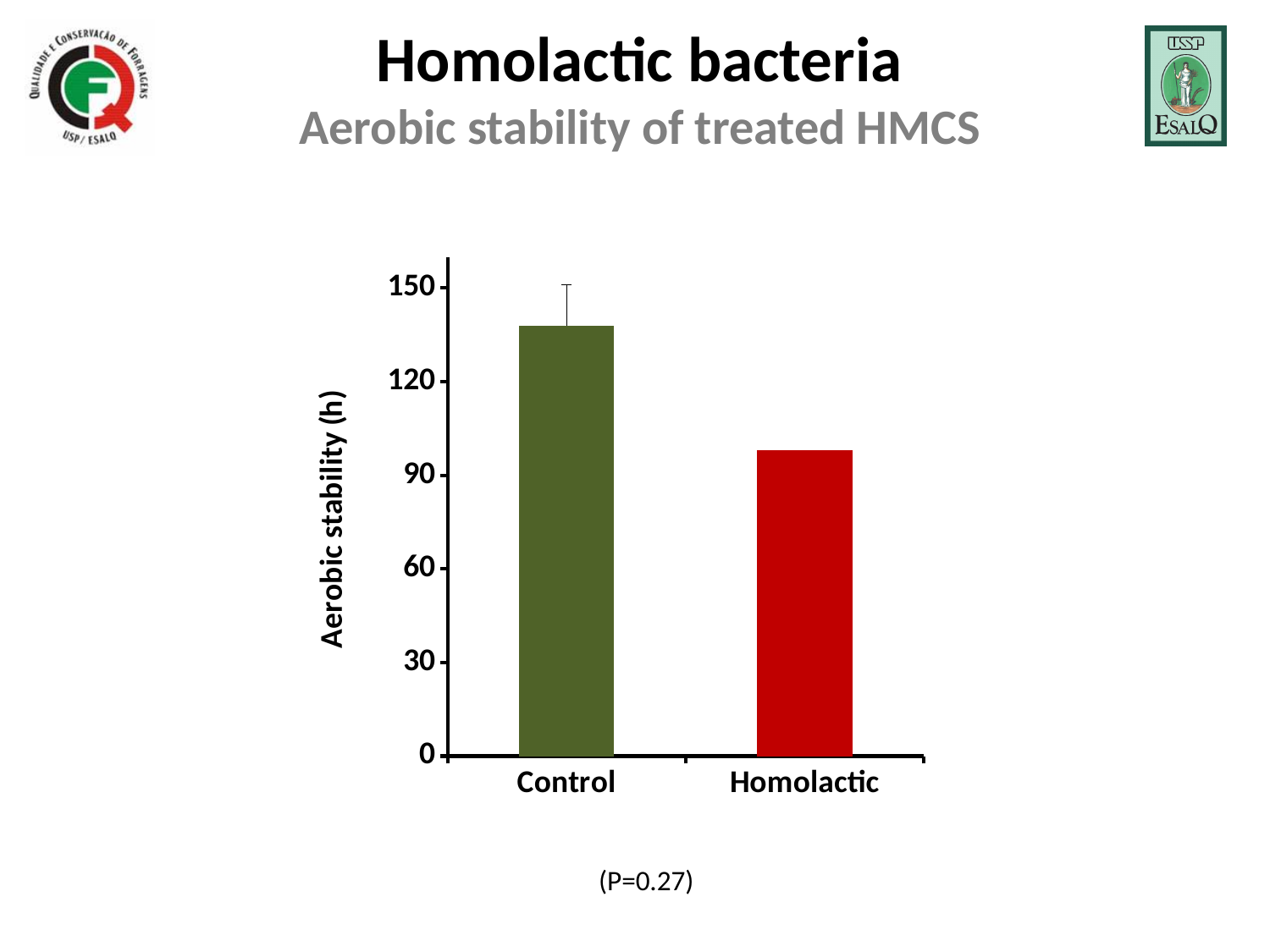
How many bars (categories) does the chart show? 2 Is the value for Control greater or less than 120? greater What colour is the Homolactic bar? red Is the value for Homolactic greater or less than 60? greater Is the value for Control greater or less than 150? less What is the label of the vertical axis? Aerobic stability (h) Which category has the lowest aerobic stability? Homolactic What kind of chart is shown on the slide? bar chart Which has a larger aerobic stability value, Control or Homolactic? Control Which category has the highest aerobic stability? Control